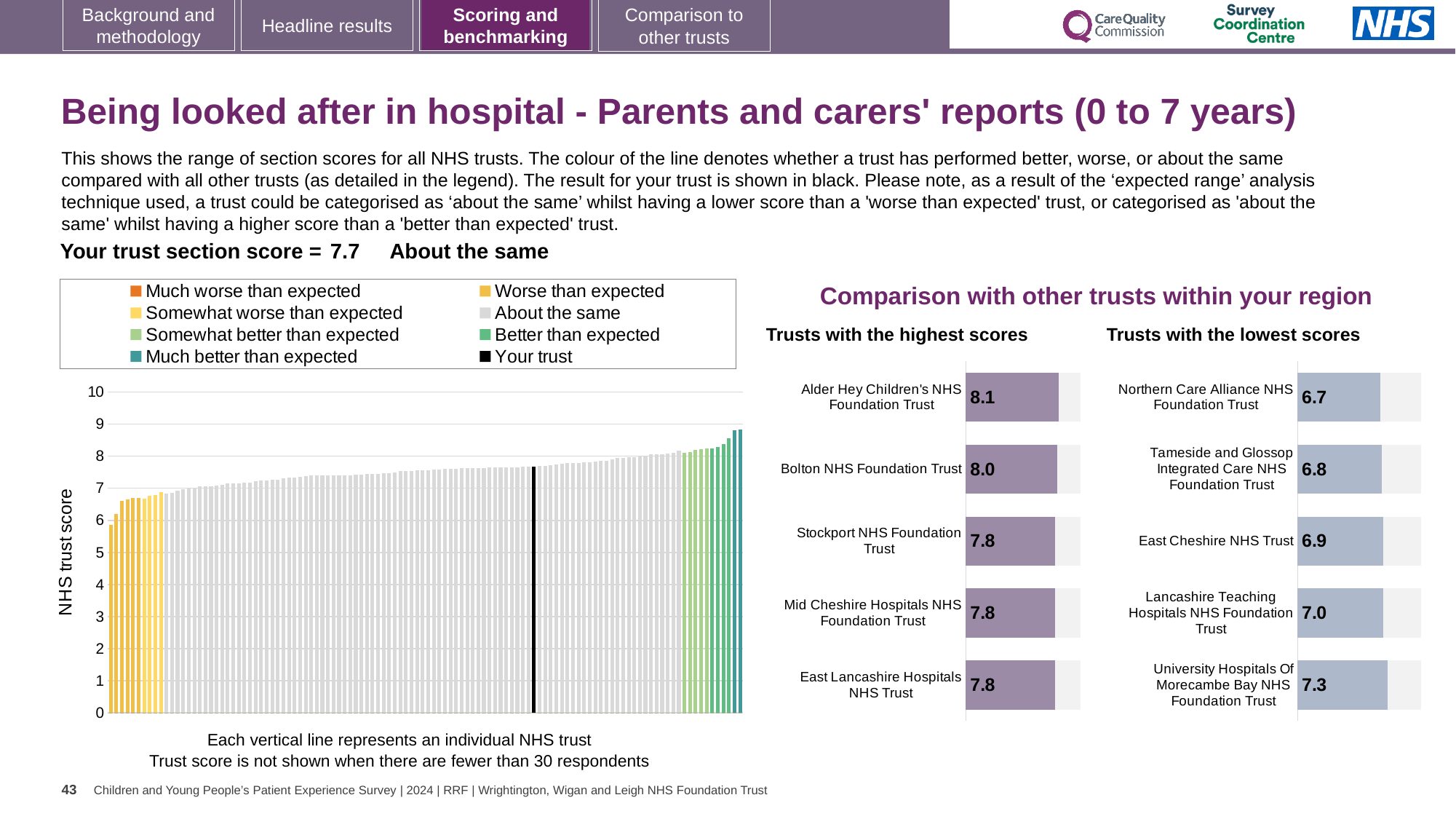
How many trusts are shown in the 'Trusts with the lowest scores' chart? 5 In the main 'NHS trust score' chart on the left, do the bar values rise or fall from left to right? rise In the 'Trusts with the highest scores' chart, what is the score for Alder Hey Children's NHS Foundation Trust? 8.1 In the 'Trusts with the highest scores' chart, what is the difference between the scores of Alder Hey Children's NHS Foundation Trust and Stockport NHS Foundation Trust? 0.3 In the main 'NHS trust score' chart on the left, is the value for the black bar (your trust) greater or less than 7? greater In the 'Trusts with the lowest scores' chart, what is the difference between the scores of University Hospitals Of Morecambe Bay NHS Foundation Trust and Northern Care Alliance NHS Foundation Trust? 0.6 In the 'Trusts with the lowest scores' chart, which trust has the lowest score? Northern Care Alliance NHS Foundation Trust Which has a higher score: Bolton NHS Foundation Trust in the 'highest scores' chart or University Hospitals Of Morecambe Bay NHS Foundation Trust in the 'lowest scores' chart? Bolton NHS Foundation Trust In the main 'NHS trust score' chart on the left, is the value of the tallest bar greater or less than 8? greater In the 'Trusts with the highest scores' chart, which trust has the highest score? Alder Hey Children's NHS Foundation Trust How many entries does the legend above the main 'NHS trust score' chart list? 8 In the 'Trusts with the lowest scores' chart, what is the score for East Cheshire NHS Trust? 6.9